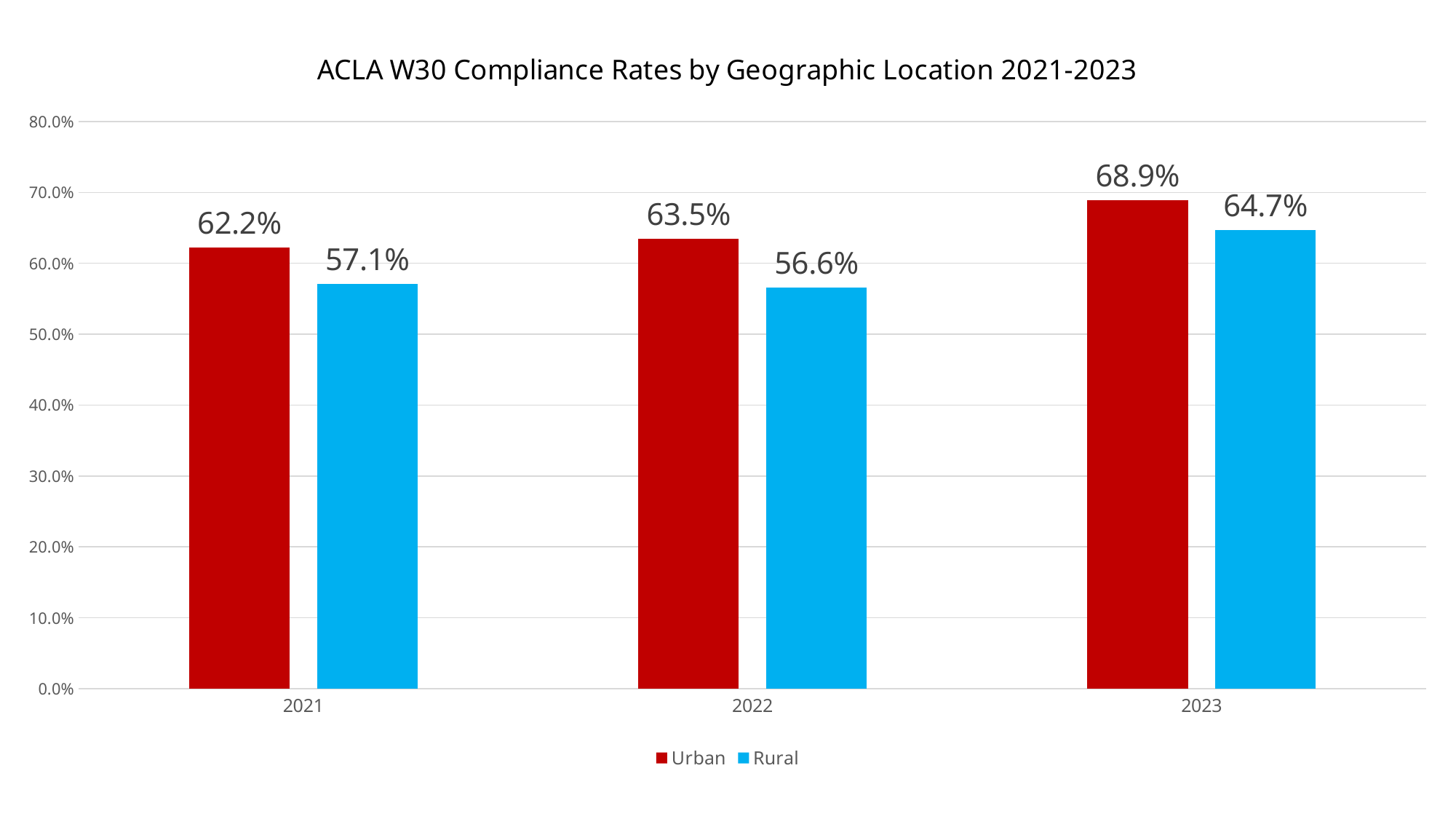
How many years are shown on the x axis? 3 Does the Urban compliance rate rise or fall from 2021 to 2023? Rise What is the difference between the Urban and Rural compliance rates in 2023? 4.2% Which is larger in 2022, the Urban or the Rural compliance rate? Urban What is the Urban compliance rate in 2021? 62.2% What is the Rural compliance rate in 2022? 56.6% What kind of chart is shown on the slide? Bar chart What is the difference between the Urban compliance rate in 2023 and in 2021? 6.7% In which year is the Urban compliance rate highest? 2023 How many series does the legend list? 2 What is the Rural compliance rate in 2023? 64.7% In which year is the Rural compliance rate lowest? 2022